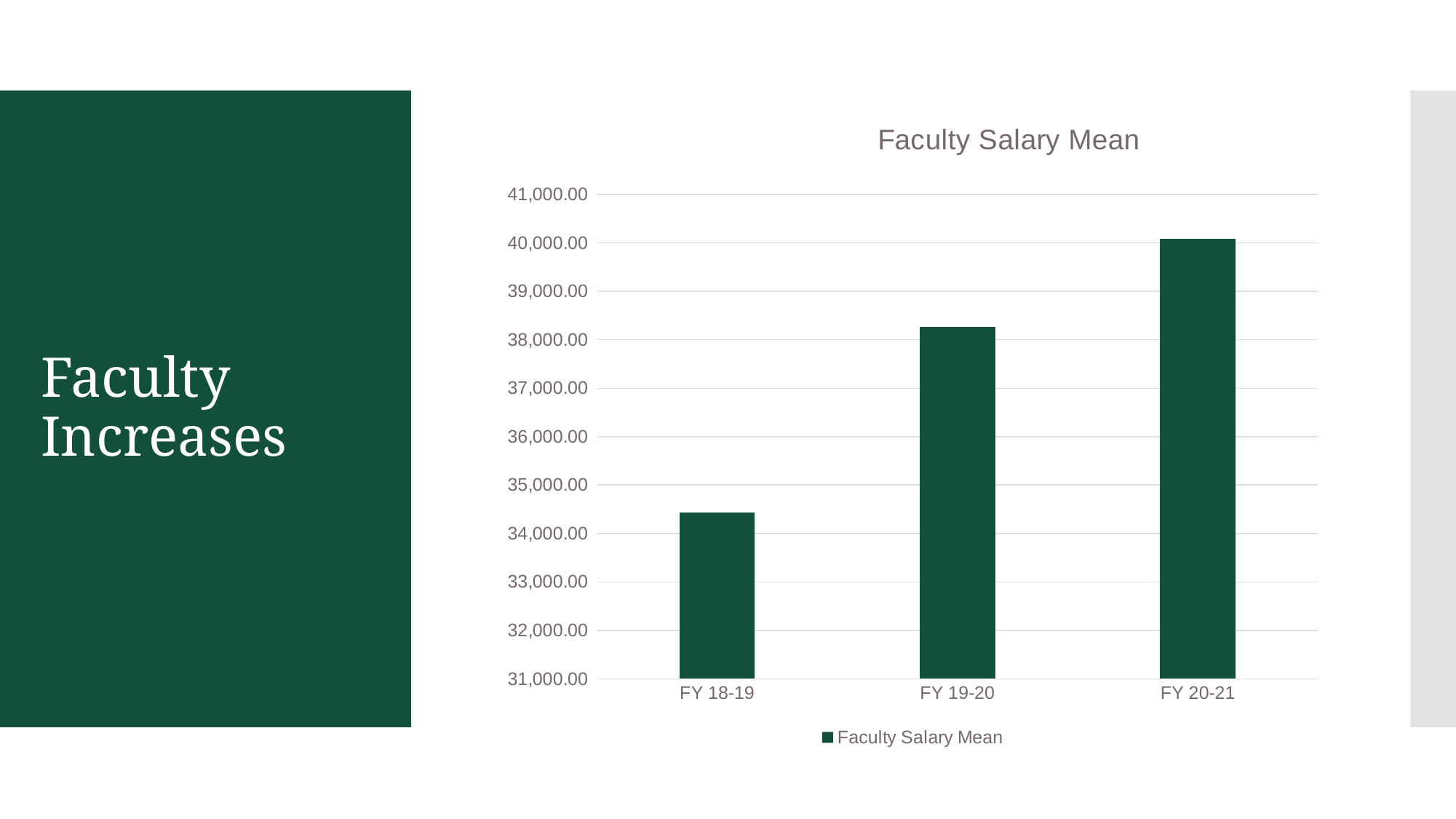
How many series does the chart legend list? 1 What is the name of the series shown in the chart legend? Faculty Salary Mean What kind of chart is shown on the slide? bar chart Is the Faculty Salary Mean for FY 19-20 greater or less than 38,000.00? greater Does the Faculty Salary Mean rise or fall from FY 18-19 to FY 20-21? rise Is the Faculty Salary Mean for FY 18-19 greater or less than 35,000.00? less Which is larger, the Faculty Salary Mean for FY 19-20 or for FY 18-19? FY 19-20 Which fiscal year has the highest Faculty Salary Mean? FY 20-21 How many fiscal years are shown on the x axis of the chart? 3 What is the title of the chart? Faculty Salary Mean Which fiscal year has the lowest Faculty Salary Mean? FY 18-19